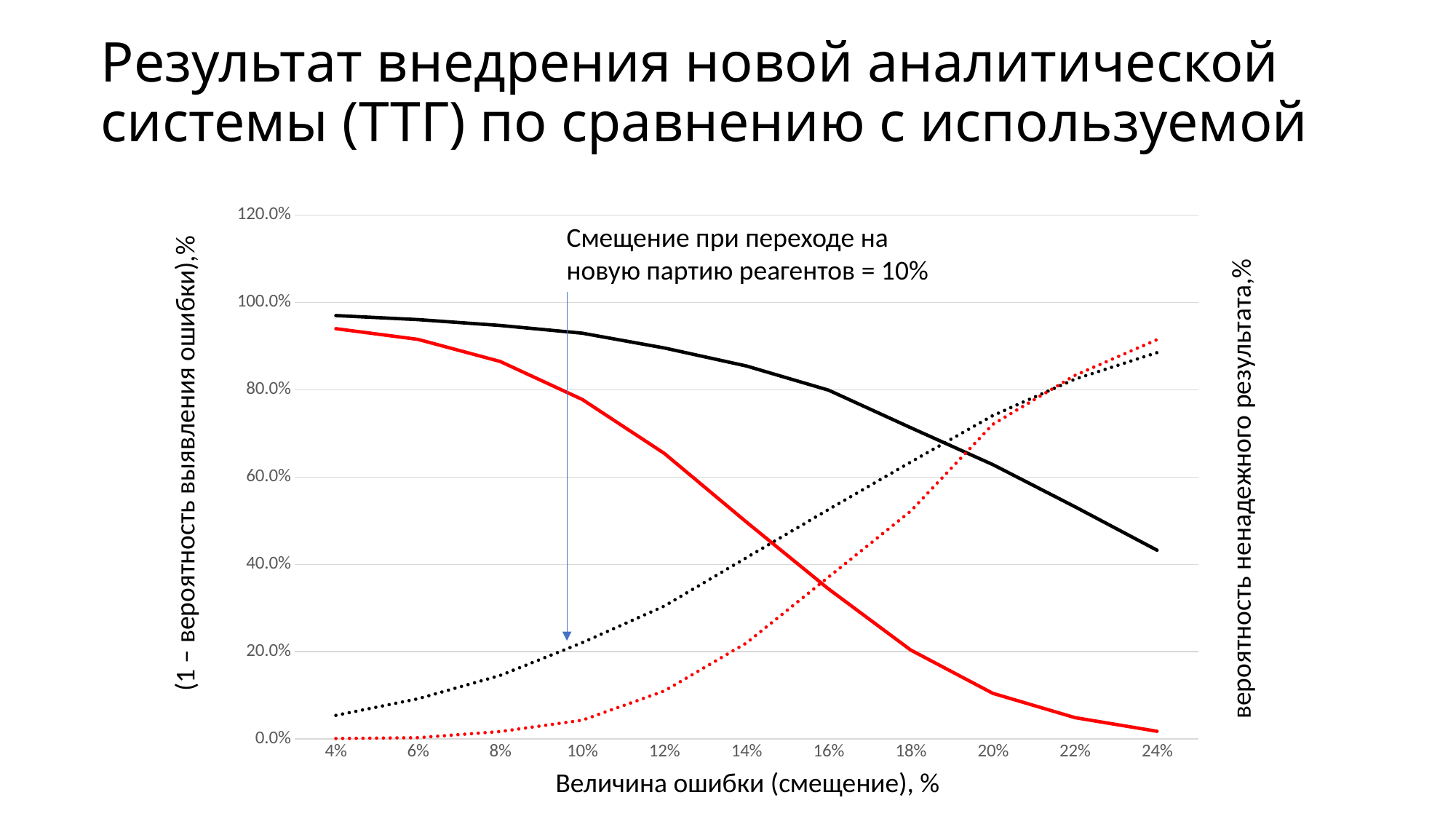
What kind of chart is shown on the slide? Line chart How many lines are plotted on the chart? 4 Is the value of the dotted black line at 4% greater or less than 20.0%? less Do the values of the solid black line rise or fall as the error (смещение) increases along the x axis? Fall Is the value of the solid black line at 24% greater or less than 60.0%? less What is the title of the x axis of the chart? Величина ошибки (смещение), % Is the value of the solid red line at 4% greater or less than 80.0%? greater How many points are marked on the x axis of the chart? 11 What value of the shift (смещение) does the annotation on the chart indicate for switching to a new batch of reagents? 10% Do the values of the dotted red line rise or fall as the error (смещение) increases along the x axis? Rise At 20% on the x axis, which is larger: the solid black line or the solid red line? Solid black line